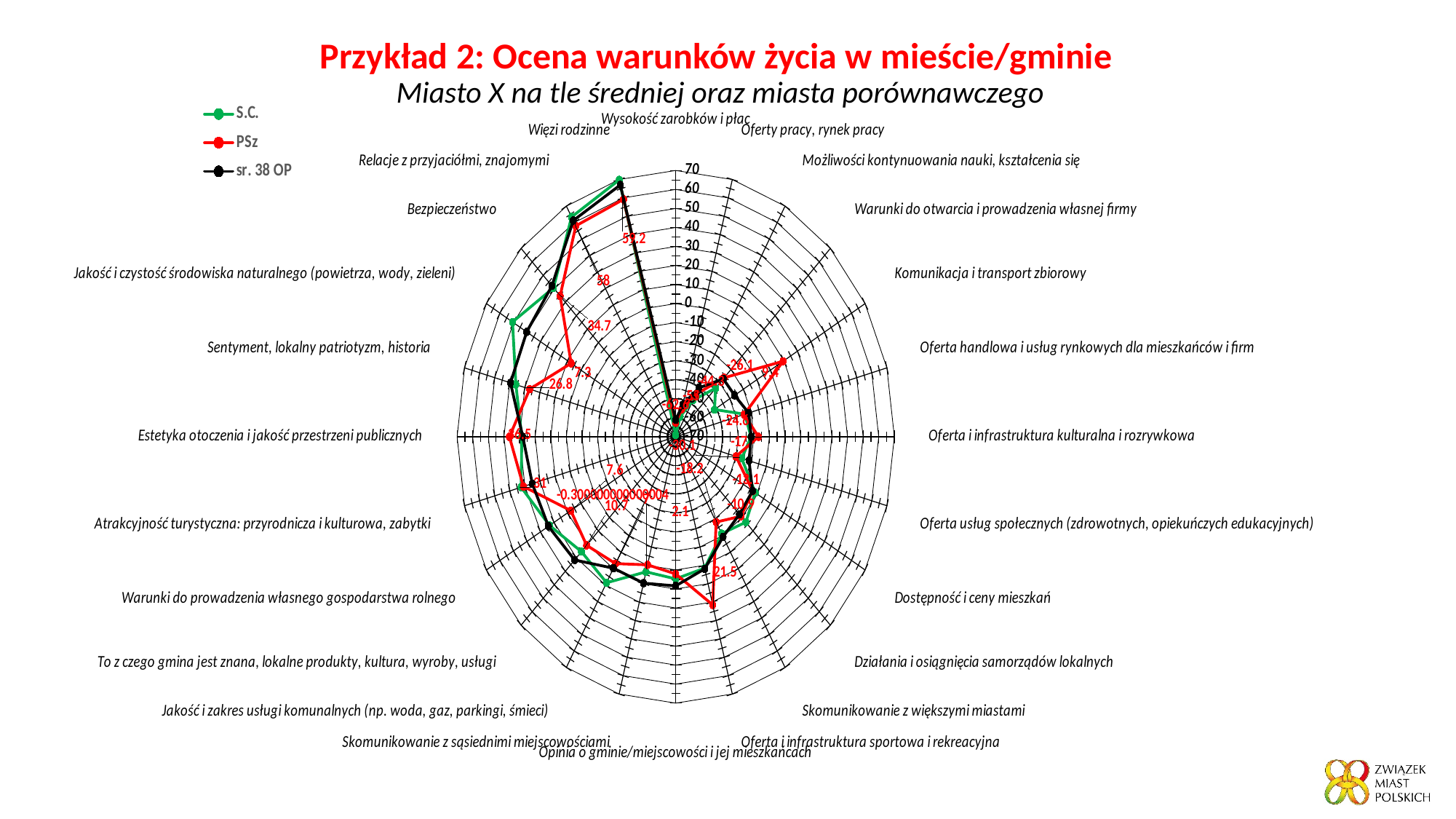
Is the value for Wysokość zarobków i płac for the PSz series greater or less than 0? less Is the value for Więzi rodzinne for the S.C. series greater or less than 50? greater What is the maximum value shown on the radial axis? 70 How many series does the legend list? 3 How many categories (axes) does the radar chart have? 24 Which series are listed in the legend? S.C., PSz, sr. 38 OP What kind of chart is shown on the slide? radar chart